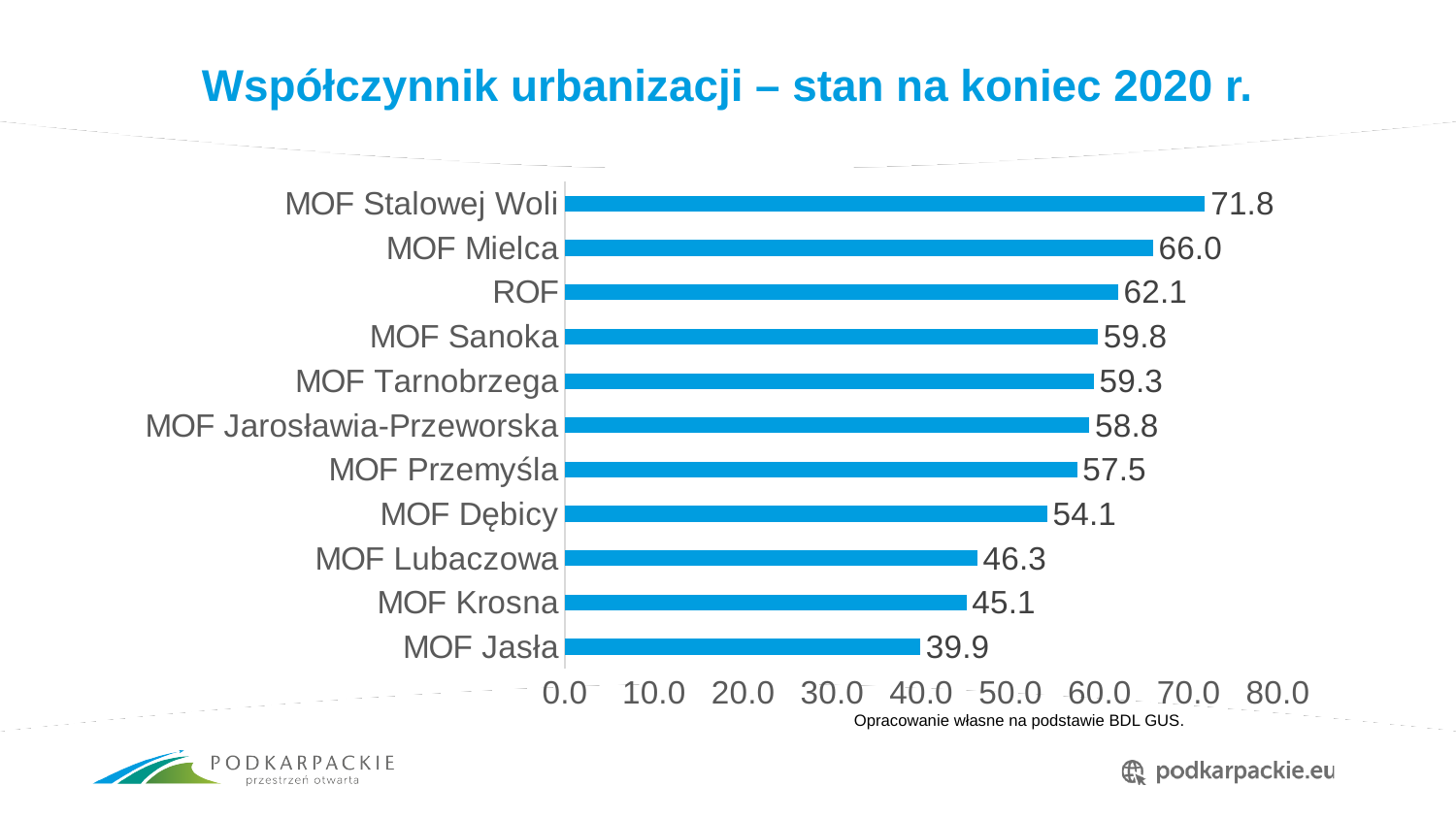
What kind of chart is shown on the slide? Bar chart What is the title of the chart? Współczynnik urbanizacji – stan na koniec 2020 r. What is the value for ROF? 62.1 What is the difference between the values for MOF Stalowej Woli and MOF Jasła? 31.9 What is the value for MOF Jasła? 39.9 How many categories are shown in the chart? 11 Which category has the highest value? MOF Stalowej Woli What is the value for MOF Dębicy? 54.1 What is the value for MOF Stalowej Woli? 71.8 Which category has the lowest value? MOF Jasła What is the difference between the values for MOF Mielca and MOF Sanoka? 6.2 Which is larger, the value for MOF Lubaczowa or MOF Krosna? MOF Lubaczowa